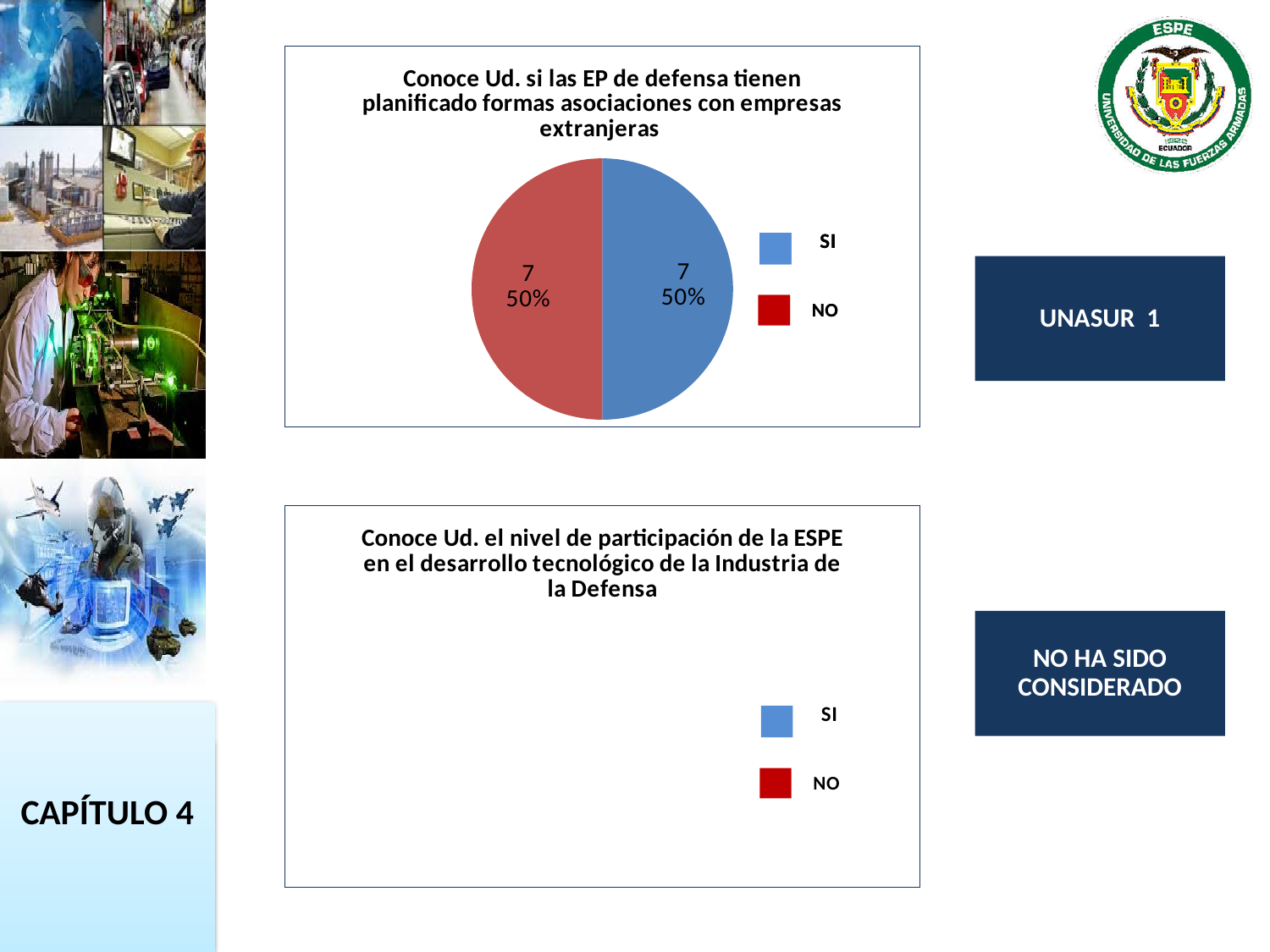
In the top pie chart, what percentage share does the SI slice have? 50% In the top pie chart, which colour represents NO? Red In the top pie chart, what is the total of the SI and NO values? 14 In the top pie chart, what percentage share does the NO slice have? 50% In the top pie chart, what is the difference between the values for SI and NO? 0 In the top pie chart, what is the value shown for SI? 7 In the top pie chart, what is the value shown for NO? 7 What are the legend entries of the bottom chart? SI and NO How many slices does the top pie chart have? 2 How many entries does the legend of the top pie chart list? 2 In the top chart titled "Conoce Ud. si las EP de defensa tienen planificado formas asociaciones con empresas extranjeras", what kind of chart is shown? Pie chart How many entries does the legend of the bottom chart titled "Conoce Ud. el nivel de participación de la ESPE en el desarrollo tecnológico de la Industria de la Defensa" list? 2